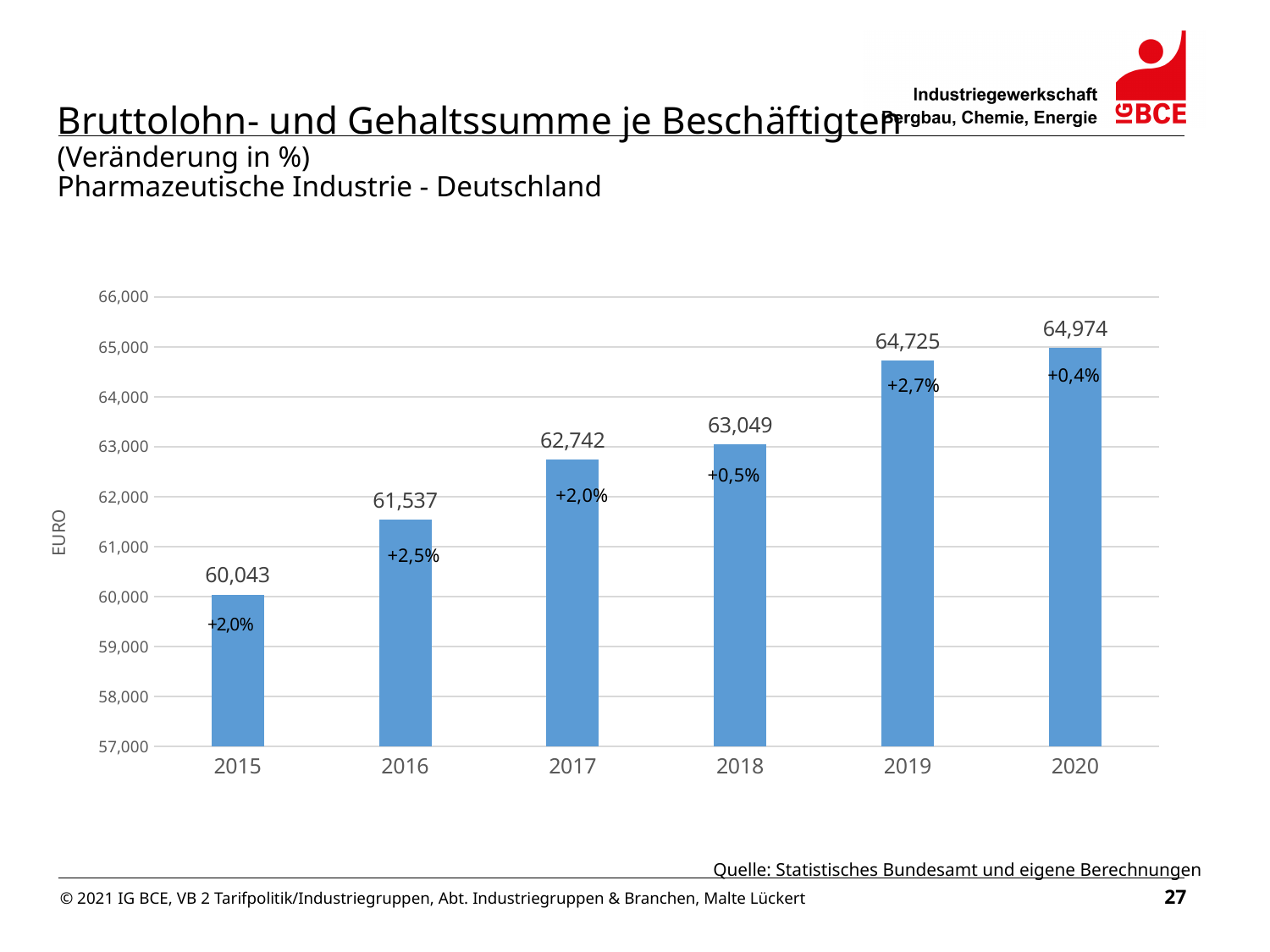
Which year has the highest value? 2020 Which year has the lowest value? 2015 What is the value for 2020? 64,974 What kind of chart is shown? bar chart What is the value for 2015? 60,043 Which is larger, the value for 2018 or the value for 2019? 2019 Do the values rise or fall from 2015 to 2020? rise What is the value for 2018? 63,049 What percentage change is shown on the bar for 2019? +2,7% Is the value for 2017 greater or less than 62,000? greater How many years are shown on the x axis? 6 What is the difference between the values for 2017 and 2016? 1,205